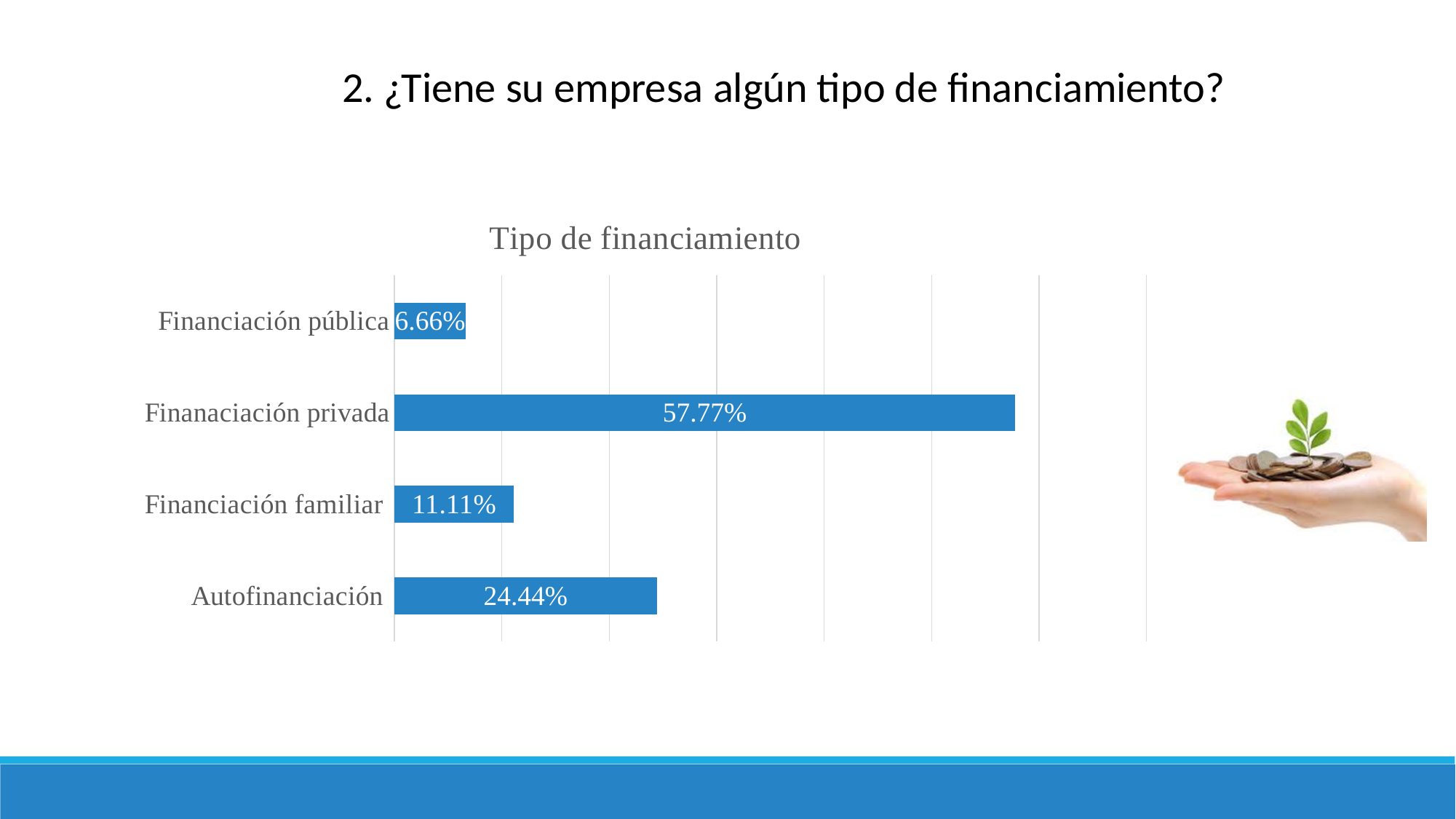
Which category has the highest value? Finanaciación privada What is the value for Finanaciación privada? 57.77% Which is larger, Autofinanciación or Financiación familiar? Autofinanciación What is the title of the chart? Tipo de financiamiento Which category has the lowest value? Financiación pública What is the value for Autofinanciación? 24.44% What is the difference between Finanaciación privada and Autofinanciación? 33.33% What is the value for Financiación familiar? 11.11% What kind of chart is shown? Bar chart What is the difference between Financiación familiar and Financiación pública? 4.45% What is the value for Financiación pública? 6.66% How many categories are shown in the chart? 4